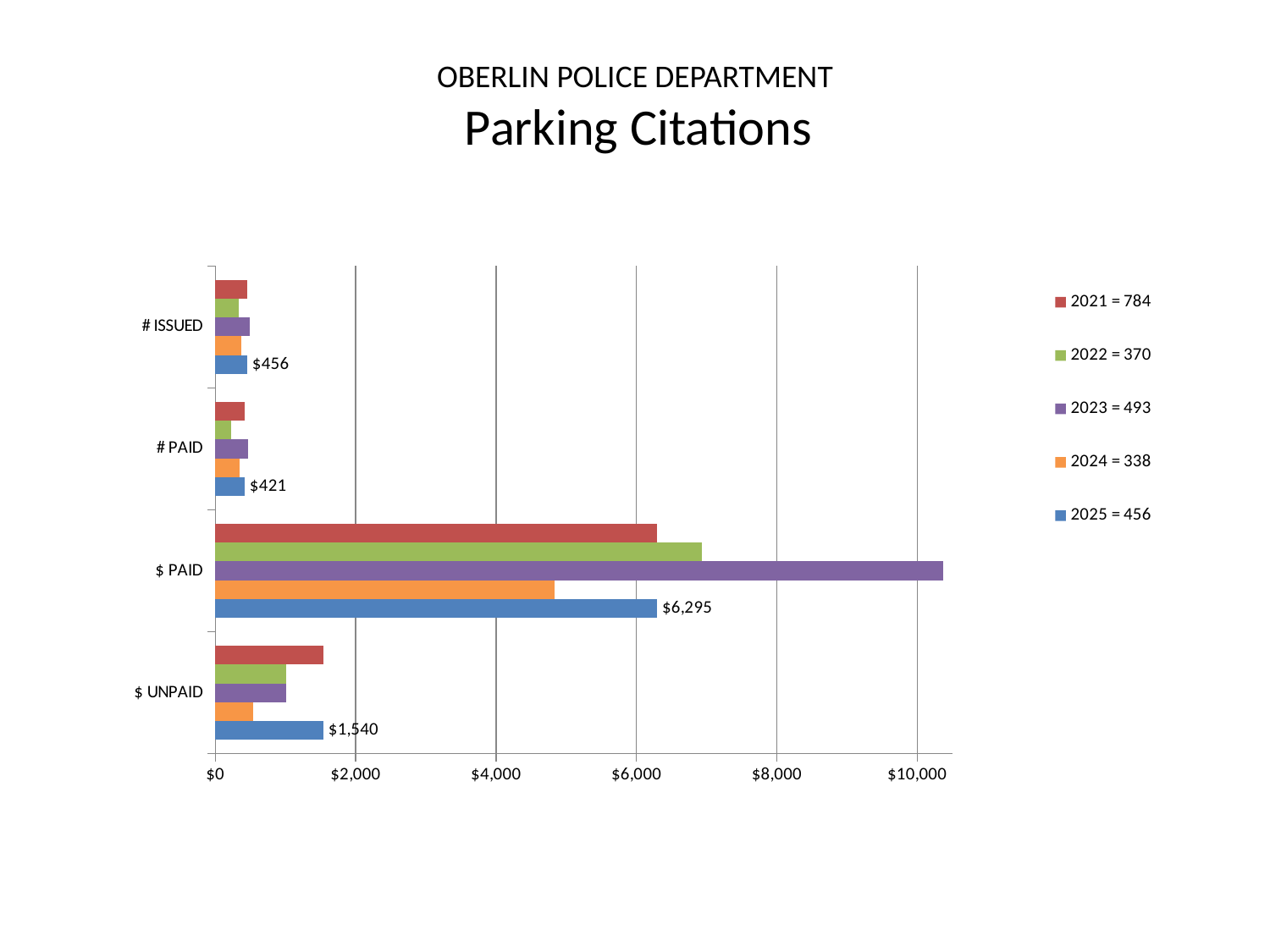
Which year has the highest value in the $ PAID category? 2023 In the $ PAID category, which is larger: the 2021 value or the 2022 value? 2022 What is the value of the 2025 series for the $ PAID category? $6,295 Which year has the lowest value in the $ UNPAID category? 2024 What is the difference between the 2025 values for $ PAID and $ UNPAID? $4,755 How many categories are shown on the vertical axis of the chart? 4 How many series does the legend list? 5 Is the 2024 value for $ PAID greater or less than $6,000? less What is the value labelled on the 2025 bar for the # PAID category? $421 Is the 2023 value for $ PAID greater or less than $10,000? greater Which year has the lowest value in the $ PAID category? 2024 What is the value of the 2025 series for the $ UNPAID category? $1,540